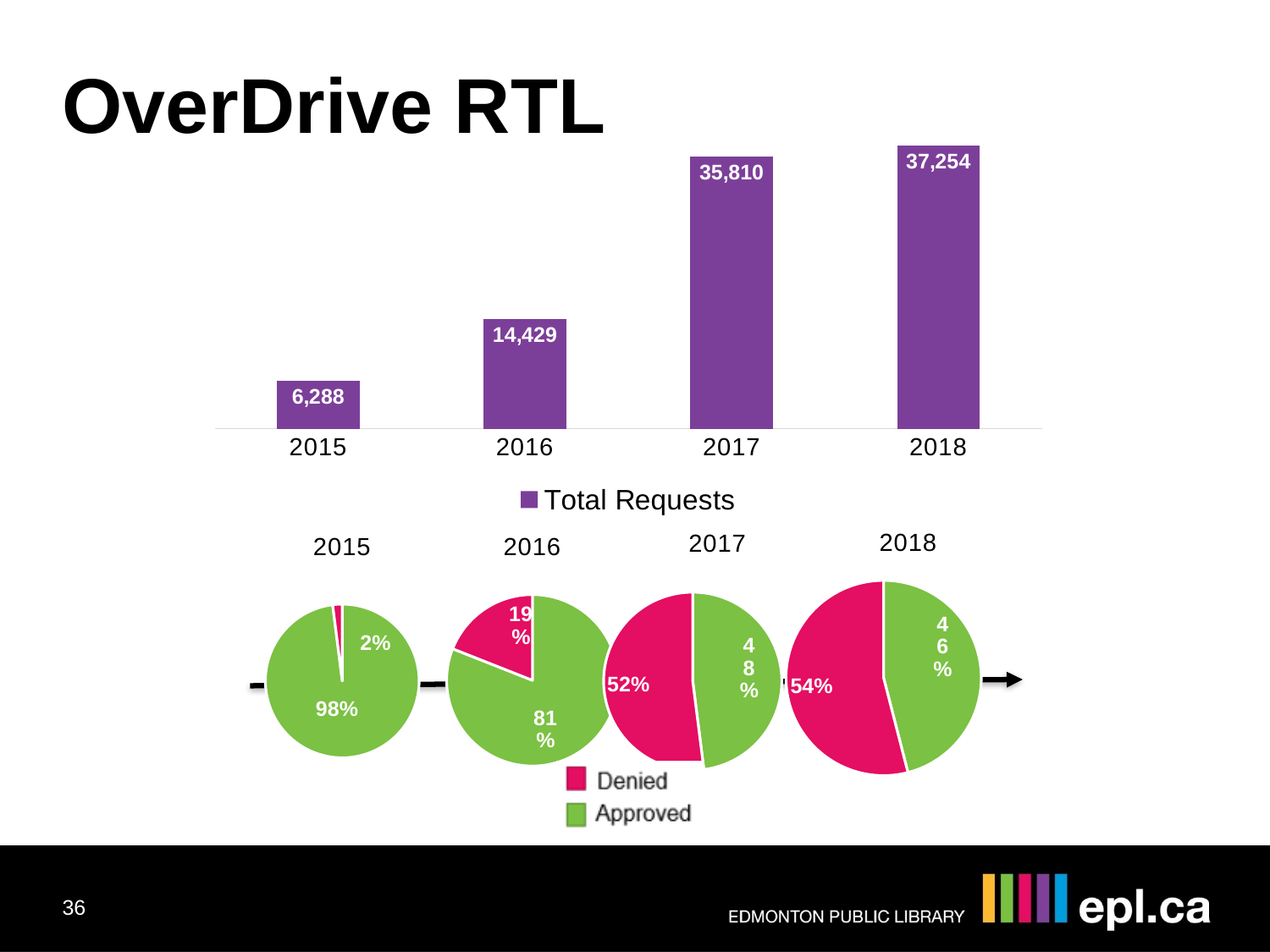
In the bar chart, which year has the lowest Total Requests? 2015 In the bar chart, which year has the highest Total Requests? 2018 In the bar chart, how many years are shown on the x axis? 4 In the 2016 pie chart, what share of requests was Denied? 19% In the bar chart, what is the value for Total Requests in 2017? 35,810 How many series does the legend of the pie charts list? 2 In the bar chart, do Total Requests rise or fall from 2015 to 2018? rise In the 2015 pie chart, what share of requests was Approved? 98% What kind of chart is the top chart showing Total Requests? bar chart In the 2018 pie chart, what share of requests was Denied? 54% In the bar chart, what is the value for Total Requests in 2015? 6,288 In the bar chart, what is the difference in Total Requests between 2018 and 2017? 1,444